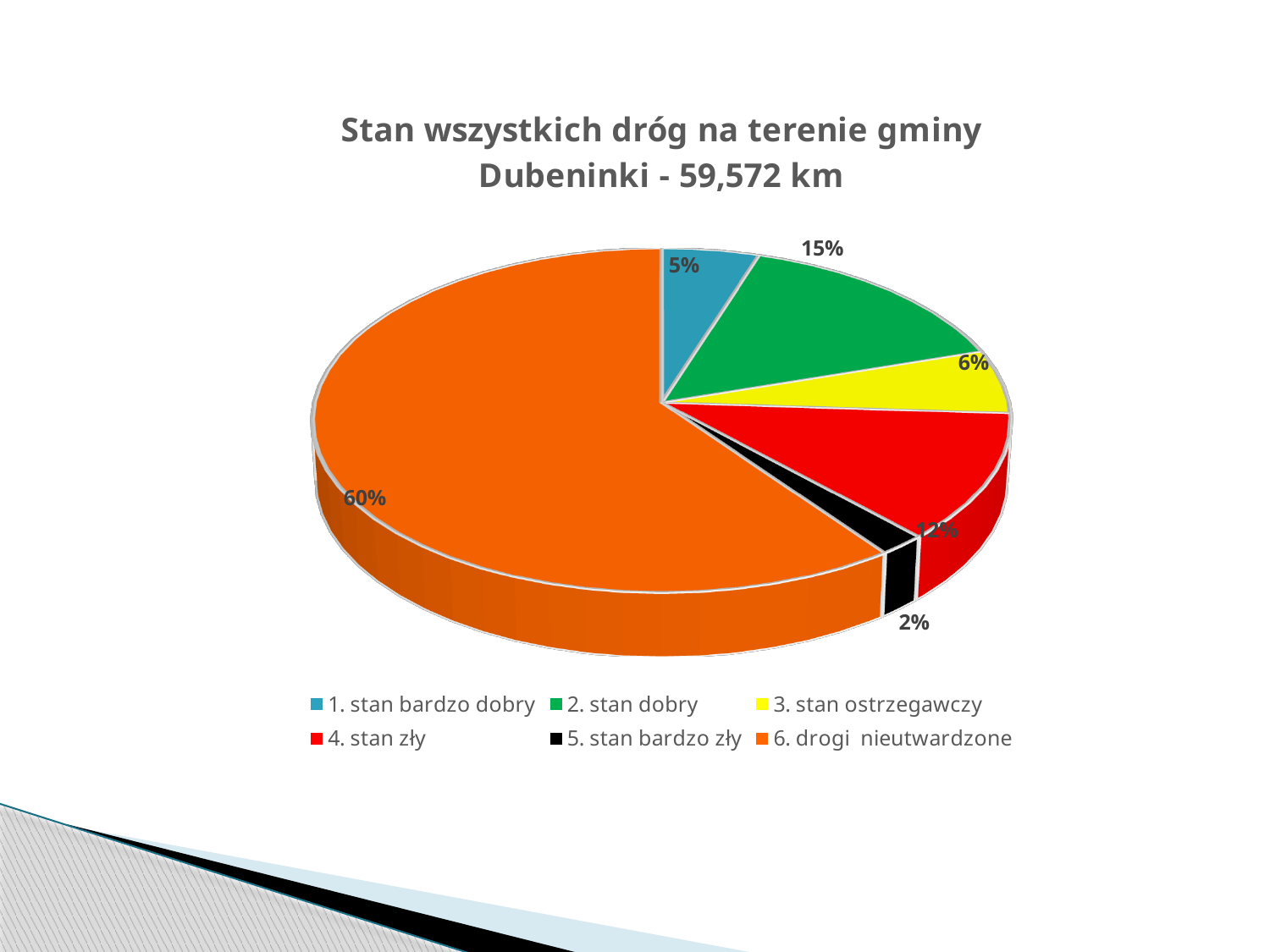
What share of the pie is labelled for "1. stan bardzo dobry"? 5% Which is larger, the share for "4. stan zły" or the share for "3. stan ostrzegawczy"? 4. stan zły Which category has the smallest slice of the pie? 5. stan bardzo zły Which category has the largest slice of the pie? 6. drogi nieutwardzone What share of the pie is labelled for "2. stan dobry"? 15% What share of the pie is labelled for "6. drogi nieutwardzone"? 60% What is the title of the chart? Stan wszystkich dróg na terenie gminy Dubeninki - 59,572 km What is the difference between the shares for "2. stan dobry" and "3. stan ostrzegawczy"? 9% How many categories does the legend list? 6 What kind of chart is shown on the slide? pie chart